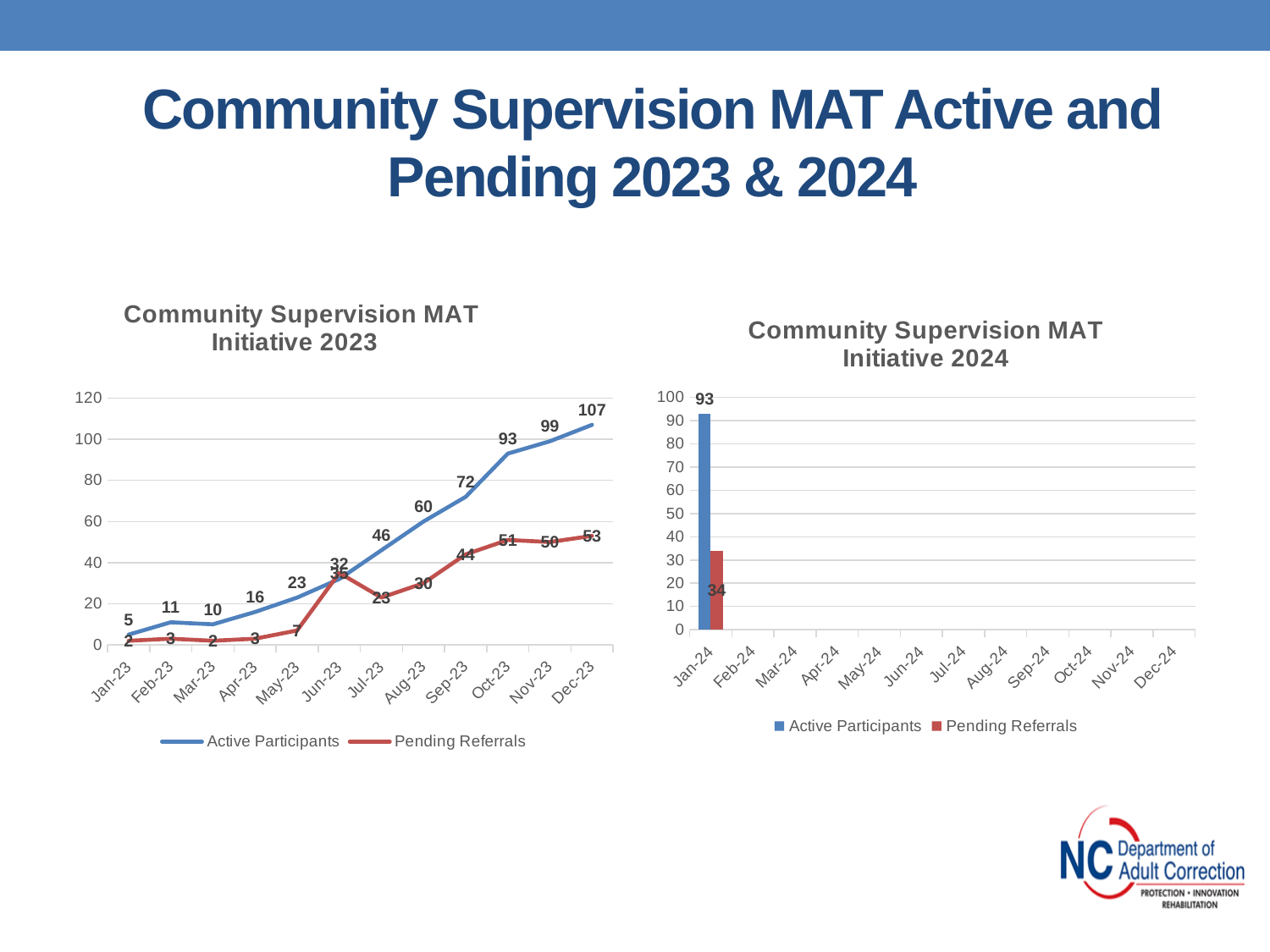
In the Community Supervision MAT Initiative 2023 chart, what is the difference between Active Participants and Pending Referrals in Dec-23? 54 In the Community Supervision MAT Initiative 2023 chart, what is the value for Active Participants in Dec-23? 107 In the Community Supervision MAT Initiative 2023 chart, which month has the highest number of Active Participants? Dec-23 In the Community Supervision MAT Initiative 2023 chart, what is the value for Pending Referrals in Sep-23? 44 In the Community Supervision MAT Initiative 2023 chart, which month has the lowest number of Active Participants? Jan-23 In the Community Supervision MAT Initiative 2024 chart, what is the value for Pending Referrals in Jan-24? 34 In the Community Supervision MAT Initiative 2023 chart, what kind of chart is used? Line chart In the Community Supervision MAT Initiative 2024 chart, how many series does the legend list? 2 In the Community Supervision MAT Initiative 2024 chart, what is the value for Active Participants in Jan-24? 93 In the Community Supervision MAT Initiative 2023 chart, which is larger in Jul-23, Active Participants or Pending Referrals? Active Participants In the Community Supervision MAT Initiative 2024 chart, what kind of chart is used? Bar chart In the Community Supervision MAT Initiative 2023 chart, do Active Participants generally rise or fall from Jan-23 to Dec-23? Rise